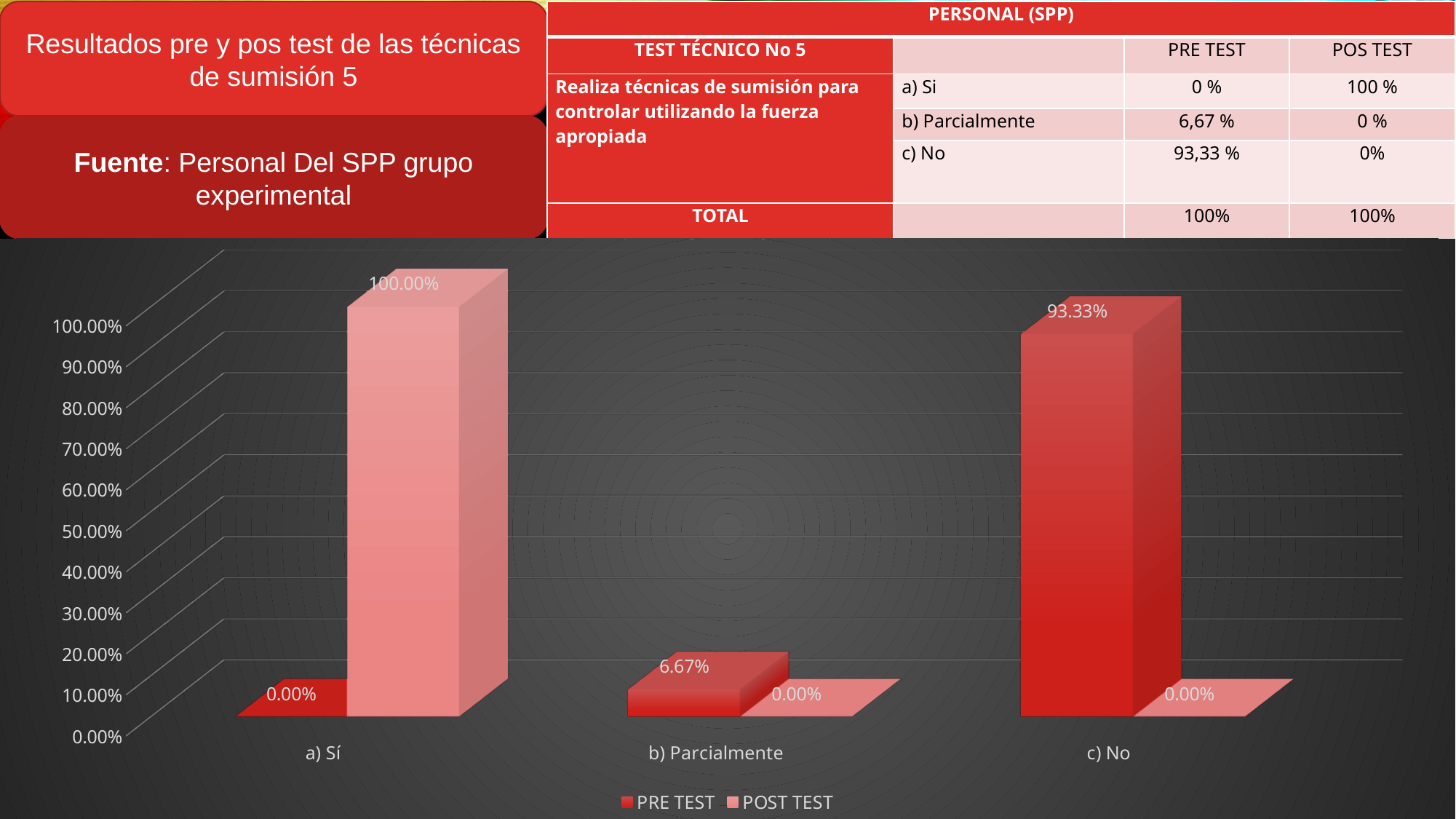
Which is larger for a) Sí: the PRE TEST value or the POST TEST value? POST TEST What is the PRE TEST value for c) No? 93.33% Which series is shown in the lighter pink colour? POST TEST How many series does the legend list? 2 What is the difference between the PRE TEST values for c) No and b) Parcialmente? 86.66% Which category has the highest POST TEST value? a) Sí What is the PRE TEST value for b) Parcialmente? 6.67% What kind of chart is shown on the slide? Bar chart What is the POST TEST value for a) Sí? 100.00% Which category has the highest PRE TEST value? c) No How many categories are shown on the x axis? 3 What is the POST TEST value for c) No? 0.00%